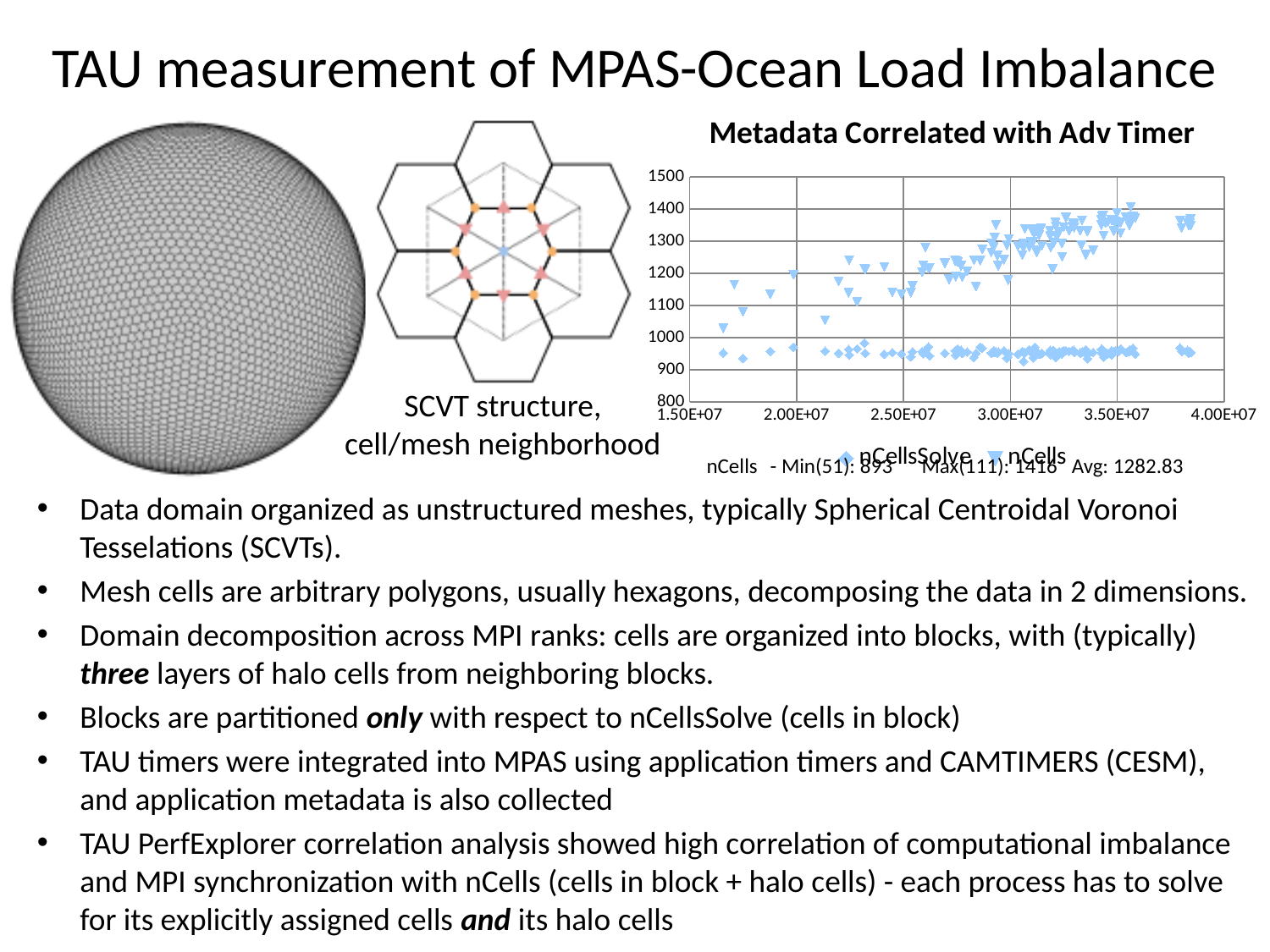
According to the text below the chart, what is the minimum nCells value? 893 Which series has the higher values at the right end of the chart, nCellsSolve or nCells? nCells What are the two series named in the chart's legend? nCellsSolve and nCells According to the text below the chart, what is the maximum nCells value? 1416 What is the title of the chart on the slide? Metadata Correlated with Adv Timer According to the text below the chart, what is the average nCells value? 1282.83 How many series does the chart's legend list? 2 Do the nCells values rise or fall as the x-axis value increases? Rise What kind of chart is shown on the slide? Scatter chart Are the nCells values near 3.50E+07 on the x-axis greater or less than 1300? Greater Are the nCellsSolve values greater or less than 1000? Less